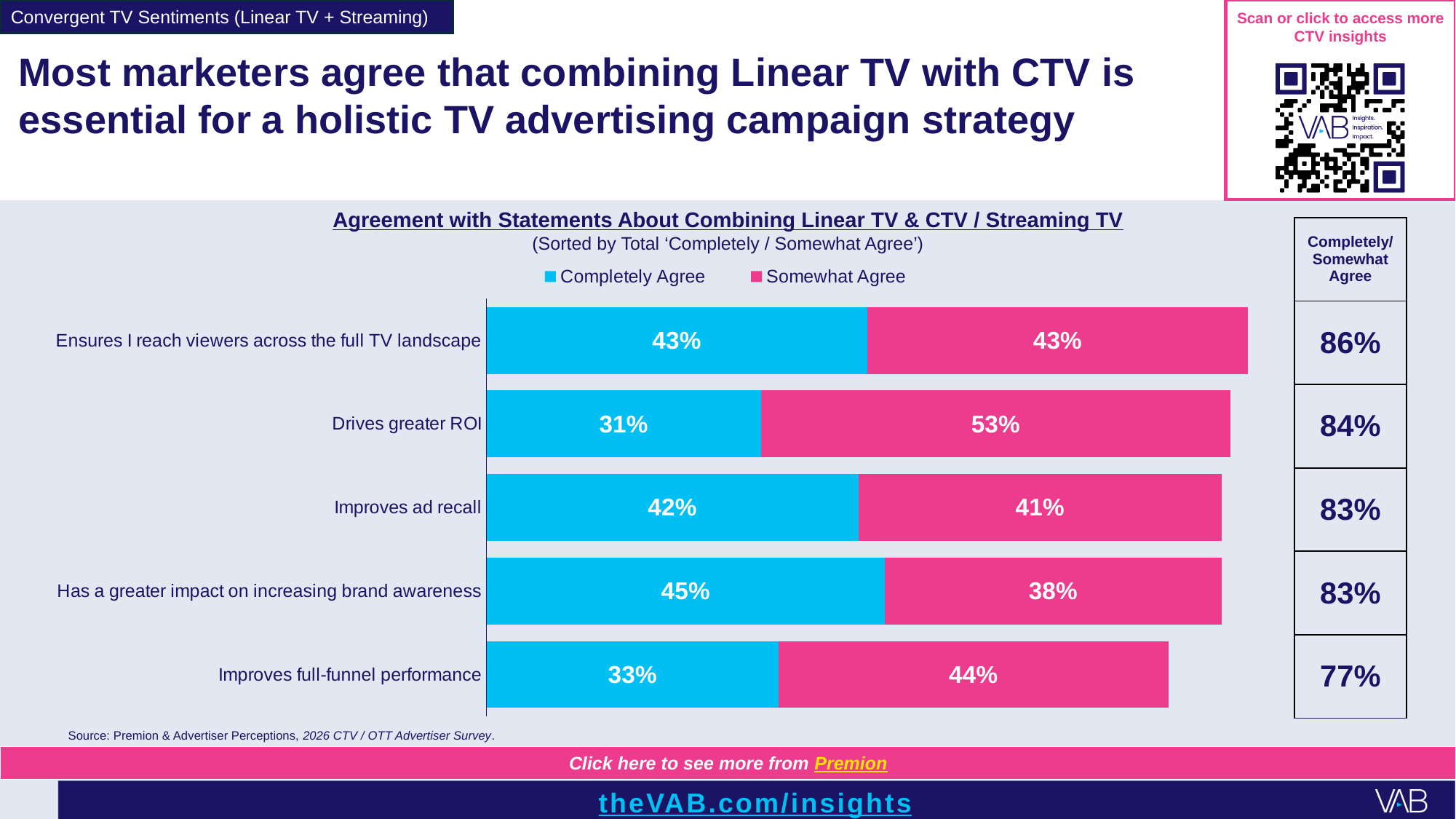
What is the Completely Agree value for 'Has a greater impact on increasing brand awareness'? 45% Which statement has the lowest Completely Agree percentage? Drives greater ROI What is the difference between the Somewhat Agree and Completely Agree values for 'Drives greater ROI'? 22% How many statements are shown in the chart? 5 What is the total Completely/Somewhat Agree for 'Improves ad recall'? 83% Which statement has the highest Completely Agree percentage? Has a greater impact on increasing brand awareness What percentage of marketers completely agree that combining Linear TV with CTV drives greater ROI? 31% Which is larger for 'Improves ad recall': the Completely Agree value or the Somewhat Agree value? Completely Agree What type of chart is shown on the slide? Stacked bar chart Which statement has the highest Somewhat Agree percentage? Drives greater ROI How many series does the legend list? 2 What is the Somewhat Agree value for 'Improves full-funnel performance'? 44%